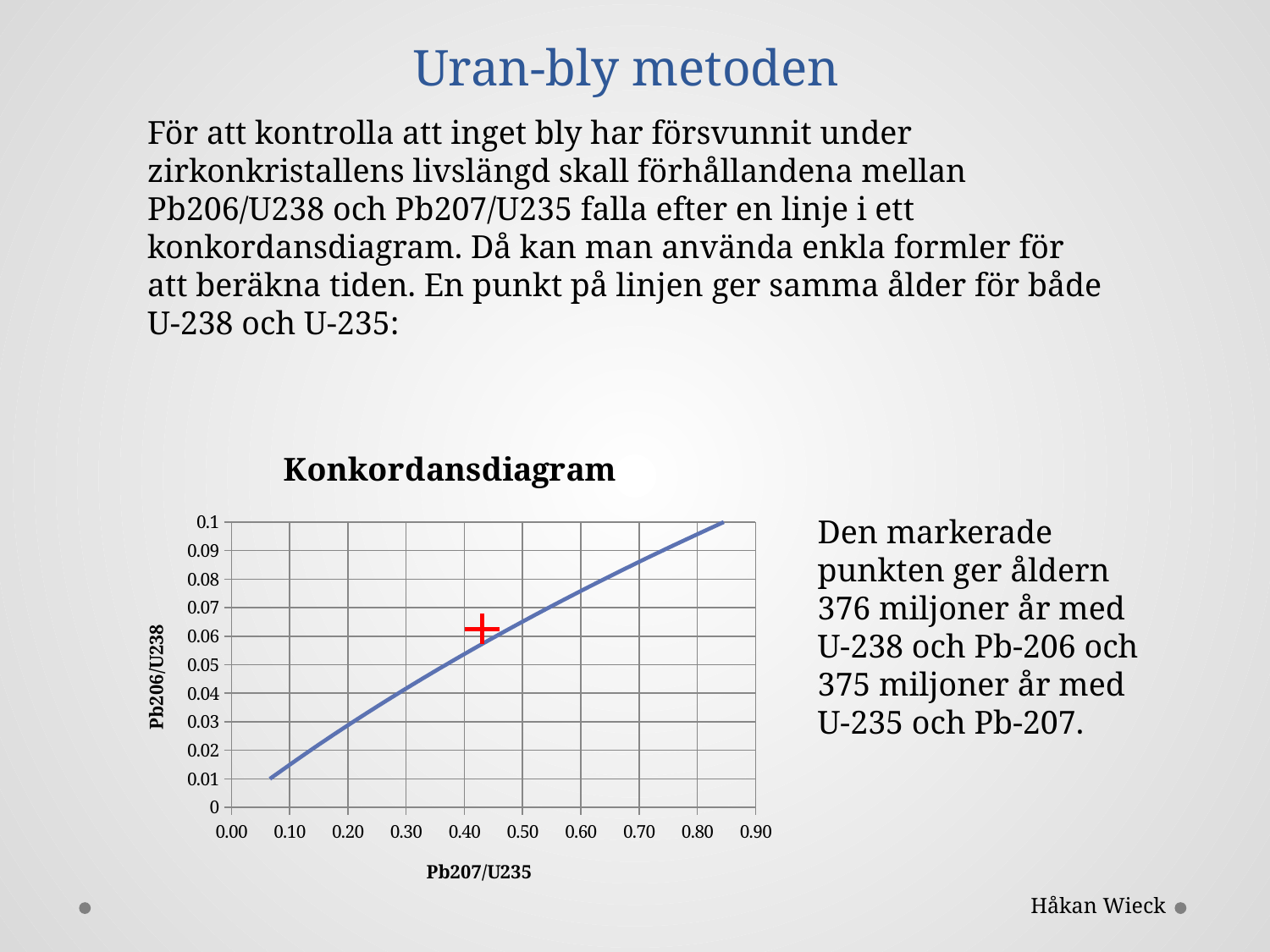
In the Konkordansdiagram, is the Pb207/U235 value of the red marked point greater or less than 0.40? greater In the Konkordansdiagram, is the Pb206/U238 value of the red marked point greater or less than 0.07? less In the Konkordansdiagram, is the Pb206/U238 value of the curve at Pb207/U235 = 0.20 greater or less than 0.02? greater Does the curve in the Konkordansdiagram rise or fall as Pb207/U235 increases? rise What is the highest tick value shown on the vertical axis of the Konkordansdiagram? 0.1 What kind of chart is the Konkordansdiagram? line chart What is the label of the vertical axis of the chart? Pb206/U238 What is the title of the chart on the slide? Konkordansdiagram What is the highest tick value shown on the horizontal axis of the Konkordansdiagram? 0.90